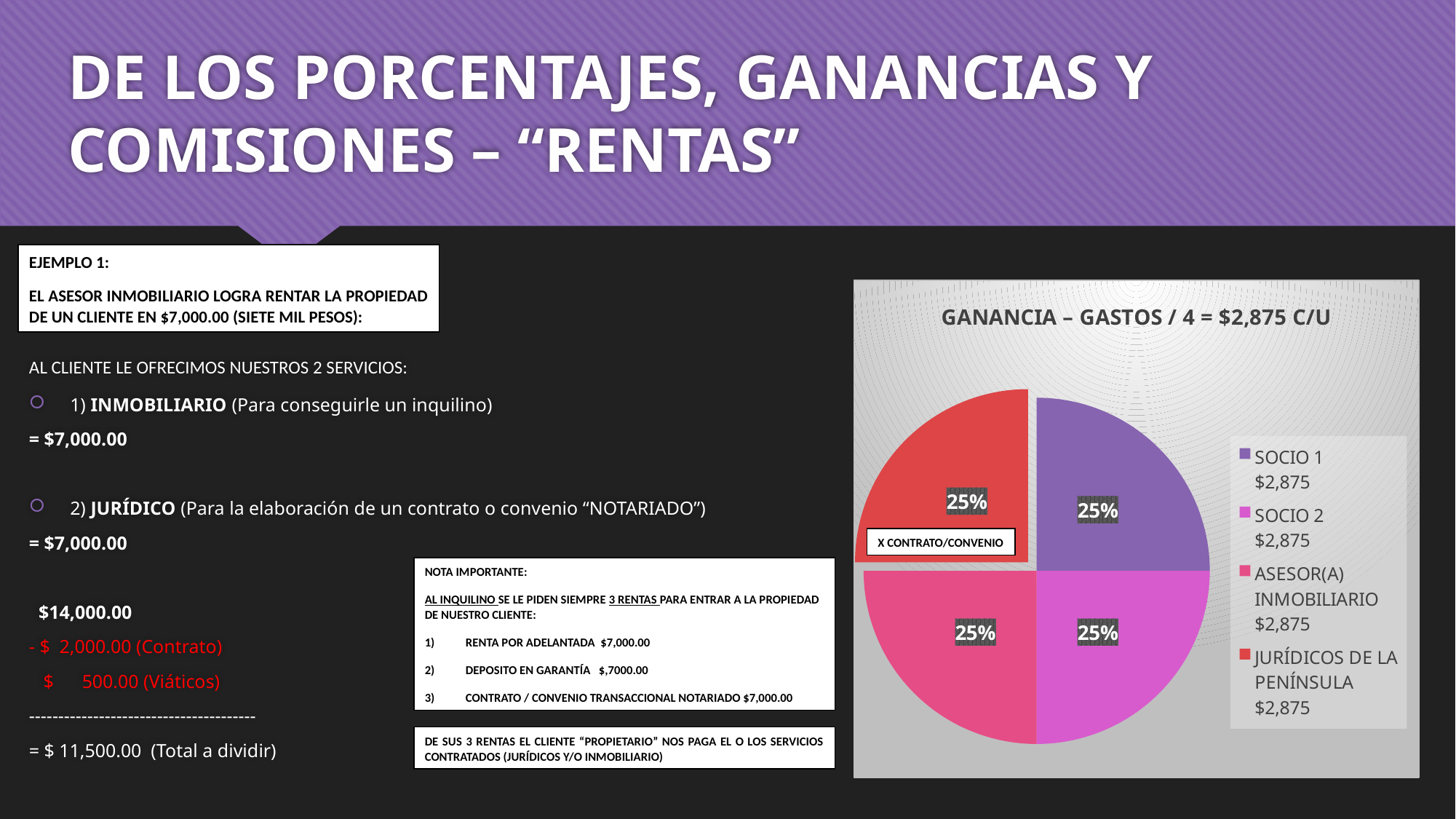
What kind of chart is shown on the slide? pie chart What amount is shown in the legend for SOCIO 2? $2,875 How many entries does the legend of the pie chart list? 4 What share of the pie does JURÍDICOS DE LA PENÍNSULA represent? 25% What label is printed on the red slice of the pie chart besides its percentage? X CONTRATO/CONVENIO What is the title of the pie chart? GANANCIA – GASTOS / 4 = $2,875 C/U Which legend entry of the pie chart is shown in purple? SOCIO 1 What is the difference between the amounts for SOCIO 1 and SOCIO 2 in the pie chart legend? $0 What share of the pie does SOCIO 1 represent? 25% How many slices does the pie chart have? 4 Do all four slices of the pie chart have the same share? yes What amount is shown in the legend for ASESOR(A) INMOBILIARIO? $2,875